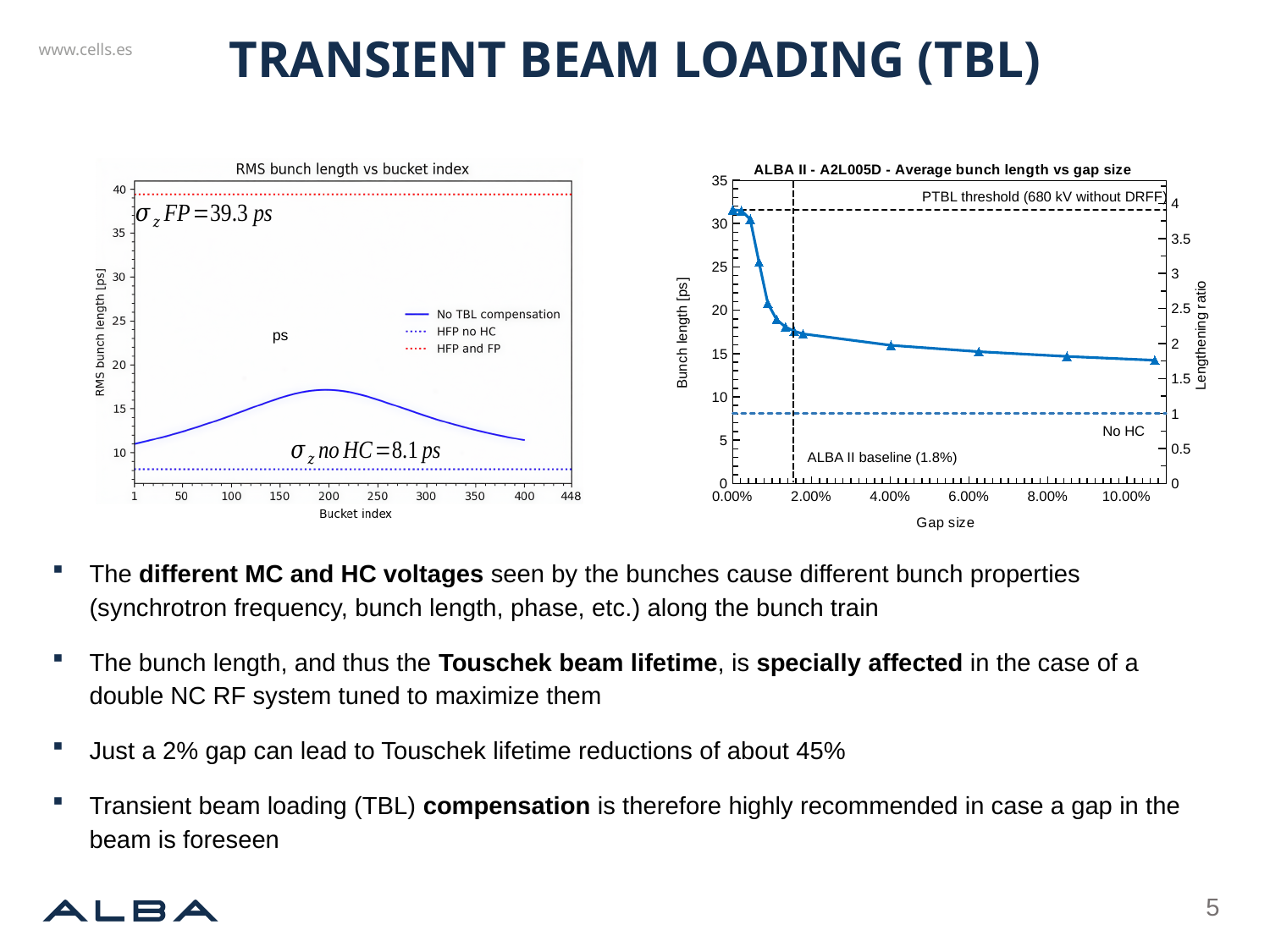
In the right chart 'ALBA II - A2L005D - Average bunch length vs gap size', is the bunch length at a gap size of 0.00% greater or less than 30 ps? greater In the left chart 'RMS bunch length vs bucket index', what value is given for σz FP? 39.3 ps In the left chart 'RMS bunch length vs bucket index', what are the three legend entries? No TBL compensation, HFP no HC, HFP and FP In the left chart 'RMS bunch length vs bucket index', which dotted line is higher, HFP and FP or HFP no HC? HFP and FP In the right chart 'ALBA II - A2L005D - Average bunch length vs gap size', what gap size is labelled as the ALBA II baseline? 1.8% In the right chart 'ALBA II - A2L005D - Average bunch length vs gap size', does the bunch length rise or fall as the gap size increases? fall In the right chart 'ALBA II - A2L005D - Average bunch length vs gap size', what is the label of the right-hand vertical axis? Lengthening ratio In the left chart 'RMS bunch length vs bucket index', what value is given for σz no HC? 8.1 ps In the left chart 'RMS bunch length vs bucket index', is the peak of the No TBL compensation curve greater or less than 15 ps? greater What kind of chart is the left chart titled 'RMS bunch length vs bucket index'? line chart How many series does the legend of the left chart 'RMS bunch length vs bucket index' list? 3 In the left chart 'RMS bunch length vs bucket index', what is the difference between σz FP and σz no HC? 31.2 ps